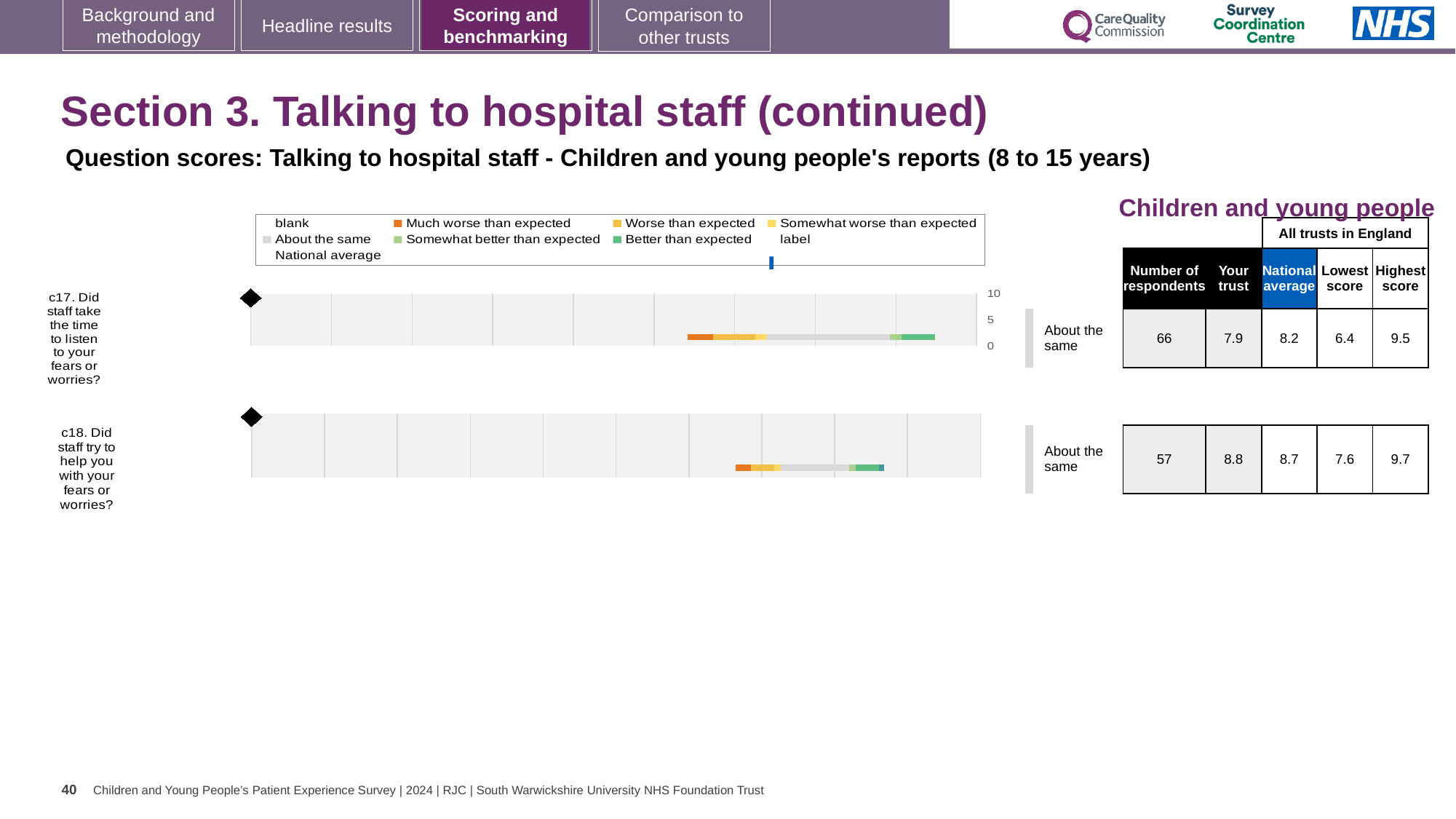
What is the national average score for question c17? 8.2 How many respondents answered question c17? 66 What is the highest score across all trusts in England for question c18? 9.7 What kind of chart is used to show the benchmarking results for c17 and c18? Bar chart Which question has the higher 'Your trust' score, c17 or c18? c18 What is the difference between the highest and lowest scores for question c18? 2.1 What benchmark category is the trust's result for question c17 placed in? About the same What is the 'Your trust' score for question c18 (Did staff try to help you with your fears or worries?)? 8.8 How many survey questions are plotted in the benchmarking chart? 2 What is the 'Your trust' score for question c17 (Did staff take the time to listen to your fears or worries?)? 7.9 What is the lowest score across all trusts in England for question c17? 6.4 What is the difference between the national average and the 'Your trust' score for question c17? 0.3